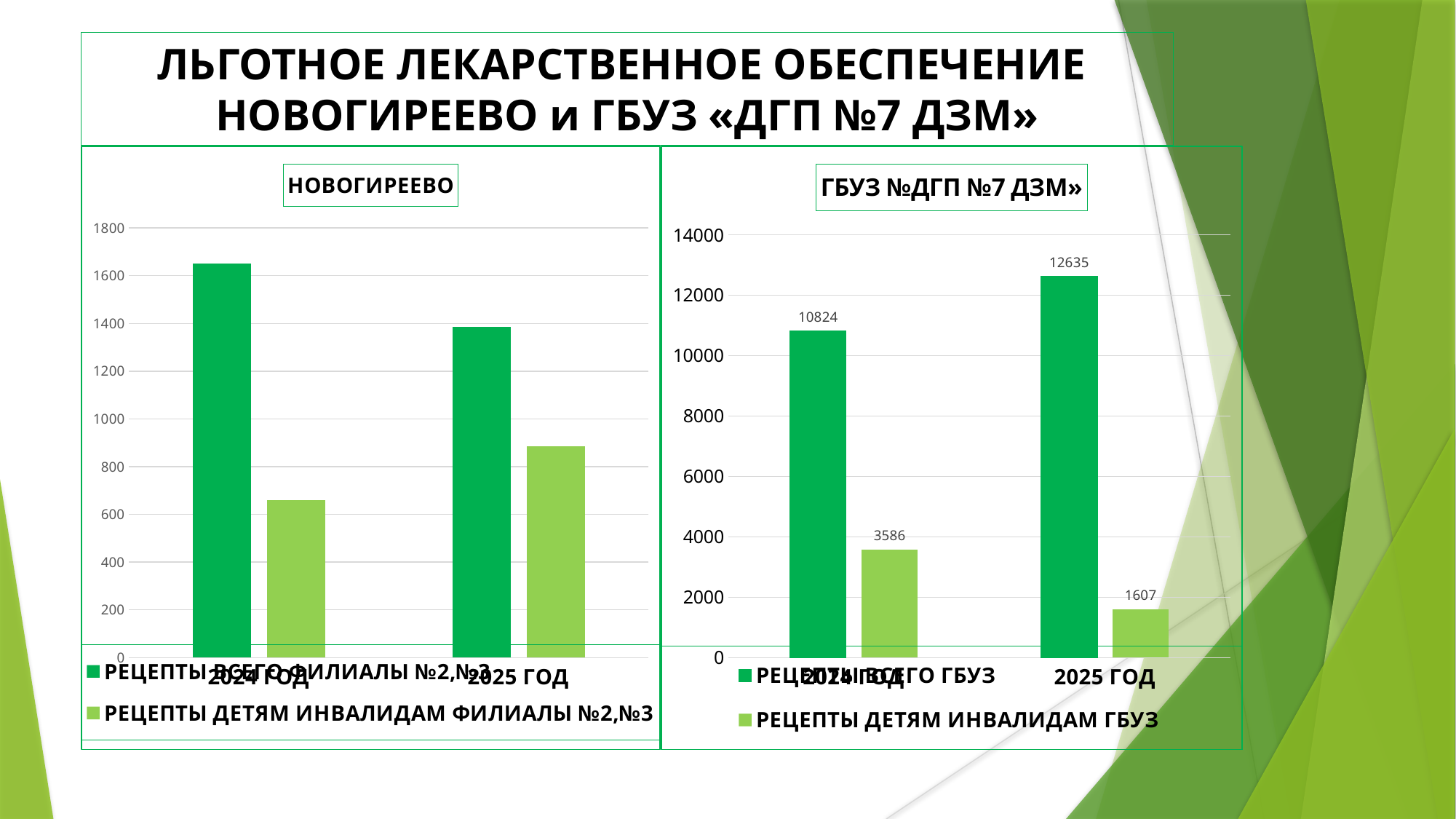
What type of chart is the НОВОГИРЕЕВО chart on the left? bar chart In the НОВОГИРЕЕВО chart on the left, is the value of РЕЦЕПТЫ ДЕТЯМ ИНВАЛИДАМ ФИЛИАЛЫ №2,№3 for 2025 ГОД greater or less than 1000? less In the ГБУЗ №ДГП №7 ДЗМ» chart on the right, what is the value of РЕЦЕПТЫ ВСЕГО ГБУЗ for 2024 ГОД? 10824 In the ГБУЗ №ДГП №7 ДЗМ» chart on the right, what is the difference between РЕЦЕПТЫ ДЕТЯМ ИНВАЛИДАМ ГБУЗ in 2024 ГОД and 2025 ГОД? 1979 In the ГБУЗ №ДГП №7 ДЗМ» chart on the right, by how much did РЕЦЕПТЫ ВСЕГО ГБУЗ increase from 2024 ГОД to 2025 ГОД? 1811 In the НОВОГИРЕЕВО chart on the left, is the value of РЕЦЕПТЫ ВСЕГО ФИЛИАЛЫ №2,№3 for 2024 ГОД greater or less than 1600? greater In the ГБУЗ №ДГП №7 ДЗМ» chart on the right, what is the value of РЕЦЕПТЫ ДЕТЯМ ИНВАЛИДАМ ГБУЗ for 2024 ГОД? 3586 How many series does the legend of the ГБУЗ №ДГП №7 ДЗМ» chart on the right list? 2 In the ГБУЗ №ДГП №7 ДЗМ» chart on the right, what is the value of РЕЦЕПТЫ ВСЕГО ГБУЗ for 2025 ГОД? 12635 In the ГБУЗ №ДГП №7 ДЗМ» chart on the right, what is the value of РЕЦЕПТЫ ДЕТЯМ ИНВАЛИДАМ ГБУЗ for 2025 ГОД? 1607 In the ГБУЗ №ДГП №7 ДЗМ» chart on the right, does РЕЦЕПТЫ ДЕТЯМ ИНВАЛИДАМ ГБУЗ rise or fall from 2024 ГОД to 2025 ГОД? fall In the НОВОГИРЕЕВО chart on the left, which year has the higher value for РЕЦЕПТЫ ДЕТЯМ ИНВАЛИДАМ ФИЛИАЛЫ №2,№3, 2024 ГОД or 2025 ГОД? 2025 ГОД